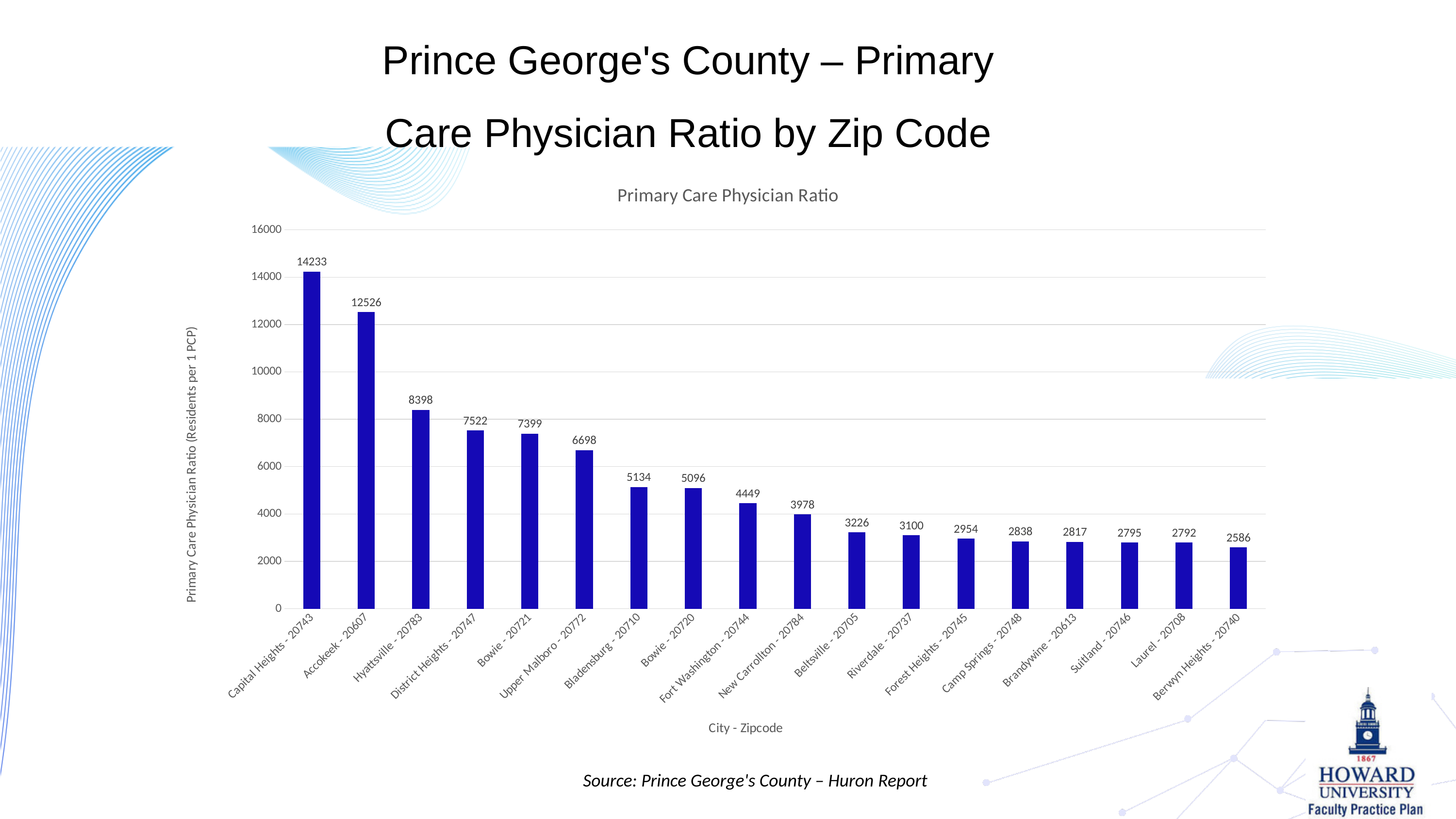
What is the difference between the values for Capital Heights - 20743 and Accokeek - 20607? 1707 How many city-zipcode categories are shown on the chart? 18 What is the difference between the values for Hyattsville - 20783 and District Heights - 20747? 876 What is the value shown for Berwyn Heights - 20740? 2586 Which has a larger value, Upper Malboro - 20772 or Fort Washington - 20744? Upper Malboro - 20772 What kind of chart is shown on the slide? bar chart Which city-zipcode has the lowest primary care physician ratio? Berwyn Heights - 20740 Which city-zipcode has the highest primary care physician ratio? Capital Heights - 20743 Is the value for Beltsville - 20705 greater or less than 4000? less What is the value shown for Bladensburg - 20710? 5134 What is the primary care physician ratio for Capital Heights - 20743? 14233 Do the values rise or fall moving from left to right along the x axis? fall